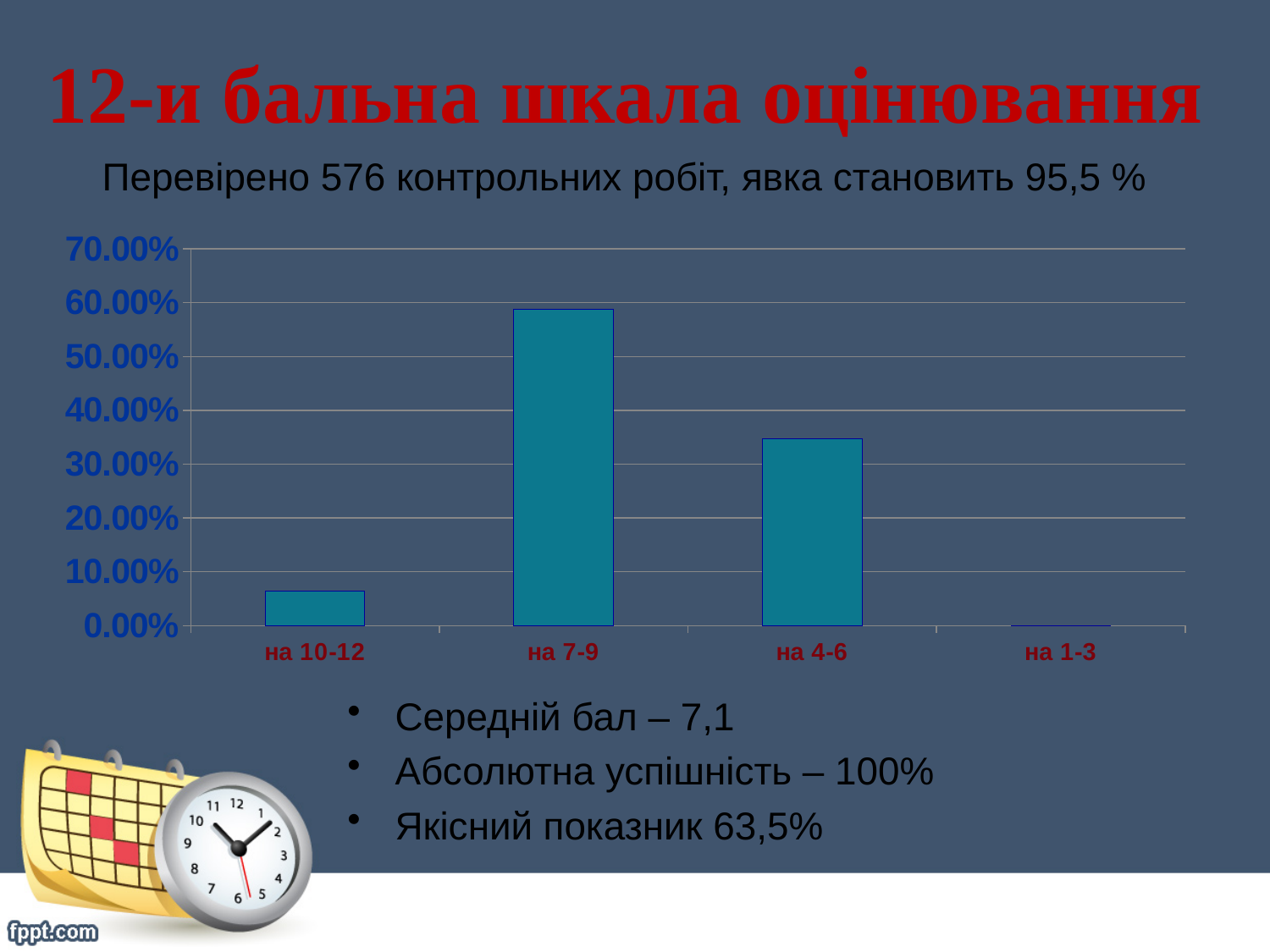
Which category has the lowest bar in the chart? на 1-3 What is the highest value shown on the chart's vertical axis? 70.00% What kind of chart is shown on the slide? bar chart Is the value for на 4-6 greater or less than 40.00%? less Which is larger, the value for на 7-9 or the value for на 4-6? на 7-9 Is the value for на 7-9 greater or less than 50.00%? greater Is the value for на 10-12 greater or less than 10.00%? less Which is larger, the value for на 4-6 or the value for на 10-12? на 4-6 How many categories are shown on the x axis of the chart? 4 Do the values rise or fall along the x axis from на 7-9 to на 1-3? fall Which category has the highest bar in the chart? на 7-9